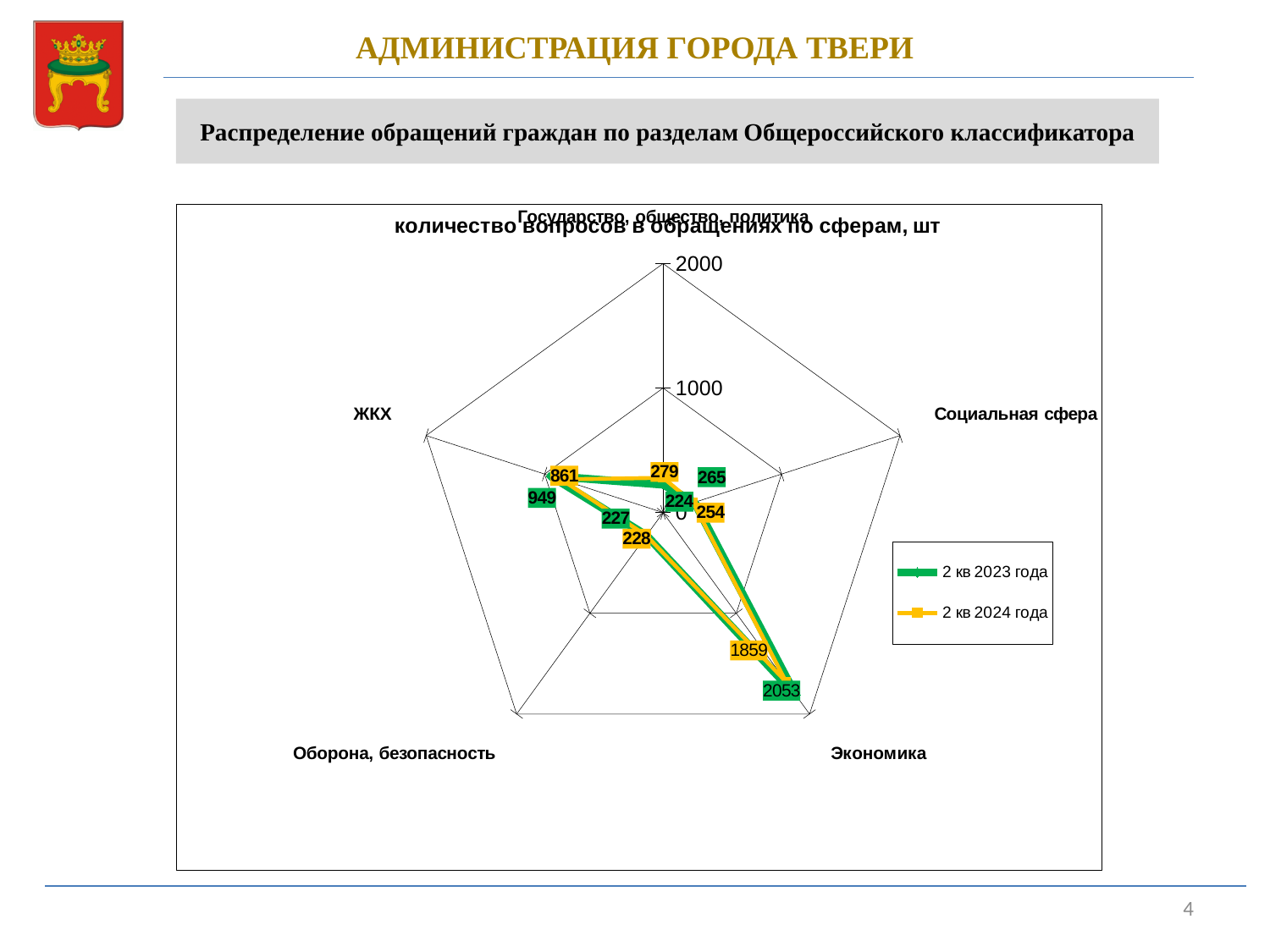
Which category has the highest number of questions in both periods? Экономика What is the value for ЖКХ in 2 кв 2024 года? 861 Which category has the lowest value in 2 кв 2023 года? Государство, общество, политика Is the value for ЖКХ in 2 кв 2024 года greater or less than 1000? less What are the two entries listed in the chart legend? 2 кв 2023 года and 2 кв 2024 года What kind of chart is shown on the slide? radar chart What is the difference between the Экономика values for 2 кв 2023 года and 2 кв 2024 года? 194 How many categories (axes) does the radar chart have? 5 How many series does the chart legend list? 2 What is the value for Экономика in 2 кв 2023 года? 2053 What is the value for Экономика in 2 кв 2024 года? 1859 For ЖКХ, which period has the larger value, 2 кв 2023 года or 2 кв 2024 года? 2 кв 2023 года